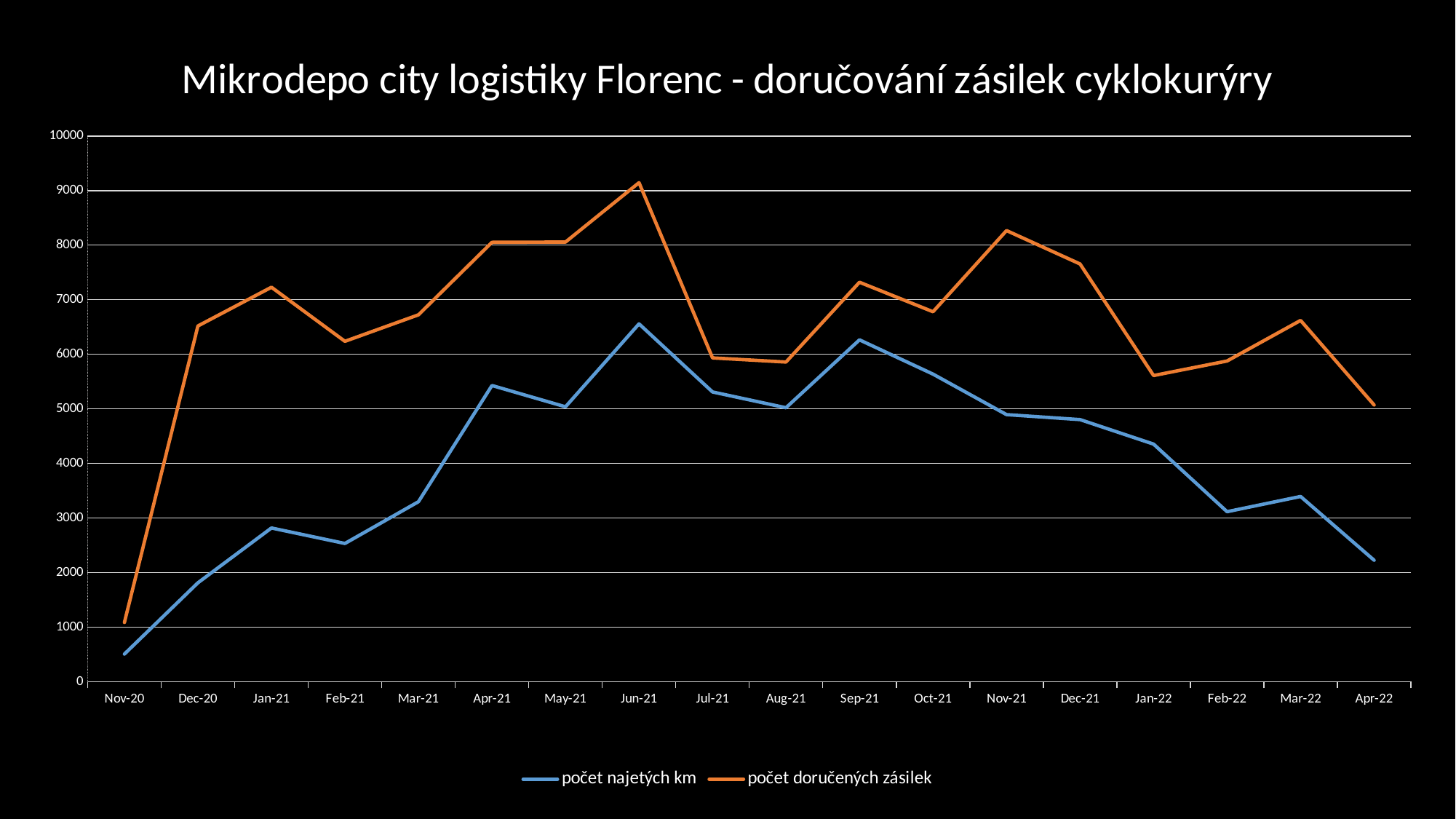
What kind of chart is shown on the slide? line chart Is the value of 'počet doručených zásilek' in Jun-21 greater or less than 9000? greater How many months are plotted along the x axis? 18 In which month does the 'počet doručených zásilek' series reach its highest value? Jun-21 What is the title of the chart? Mikrodepo city logistiky Florenc - doručování zásilek cyklokurýry In which month does the 'počet najetých km' series reach its highest value? Jun-21 How many series does the legend list? 2 In which month is the 'počet najetých km' series at its lowest? Nov-20 Is the value of 'počet najetých km' in Nov-20 greater or less than 1000? less Is the value of 'počet doručených zásilek' in Nov-21 greater or less than 8000? greater Which series has the larger value in Jun-21, 'počet najetých km' or 'počet doručených zásilek'? počet doručených zásilek Does the 'počet najetých km' series rise or fall from Nov-21 to Apr-22? fall